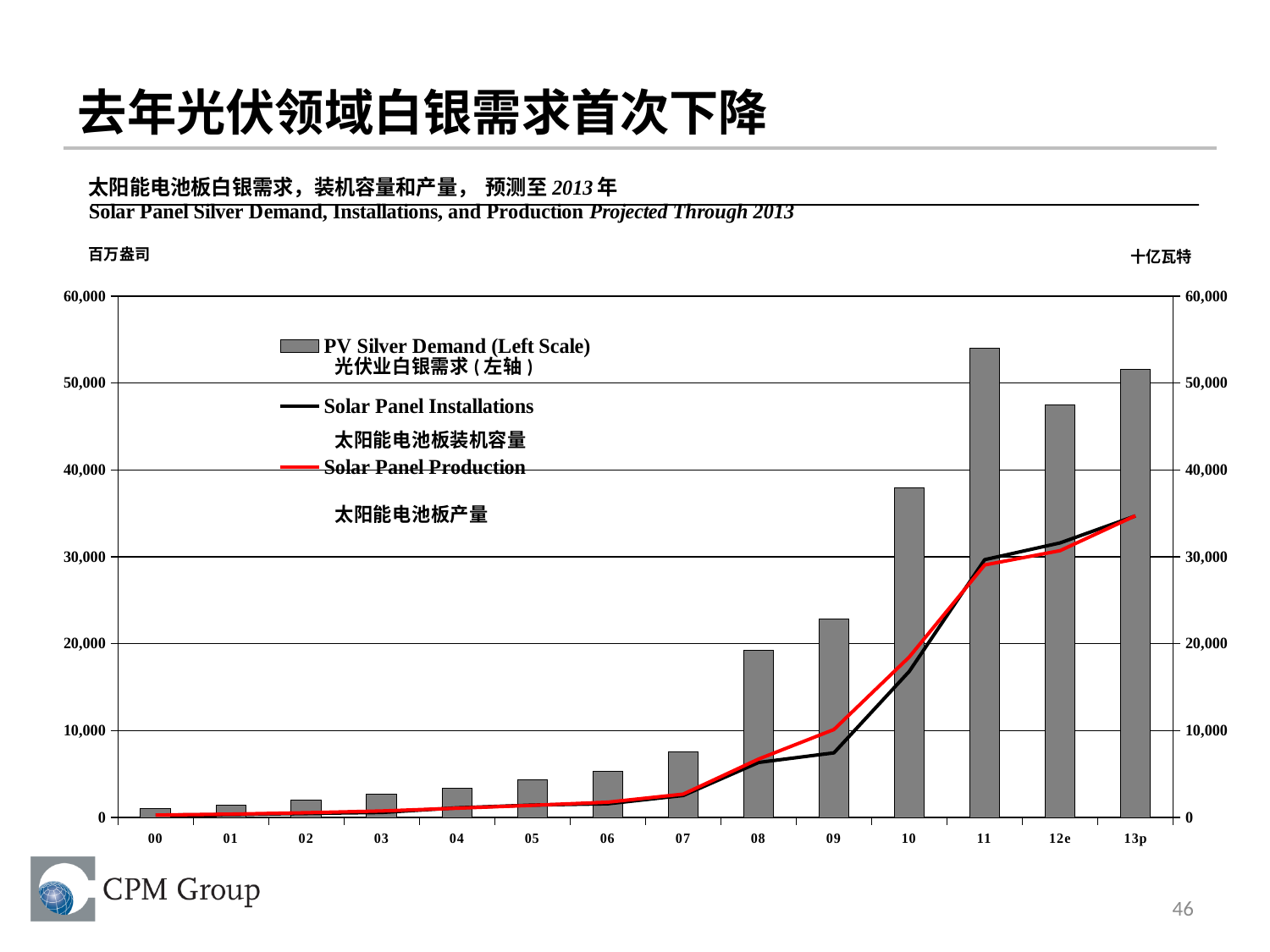
Is the PV Silver Demand bar for 10 greater or less than 40,000? less Which series in the legend is drawn as a red line? Solar Panel Production In which year is the PV Silver Demand bar the lowest? 00 In which year is the PV Silver Demand bar the highest? 11 What kind of chart is shown on the slide? A combined bar and line chart Is the PV Silver Demand bar for 11 greater or less than 50,000? greater Does the Solar Panel Production line generally rise or fall from 00 to 13p? rise How many series does the chart's legend list? 3 Which has the larger PV Silver Demand bar, 11 or 12e? 11 How many years (categories) are shown on the x axis of the chart? 14 Which has the larger PV Silver Demand bar, 12e or 13p? 13p Is the PV Silver Demand bar for 09 greater or less than 20,000? greater